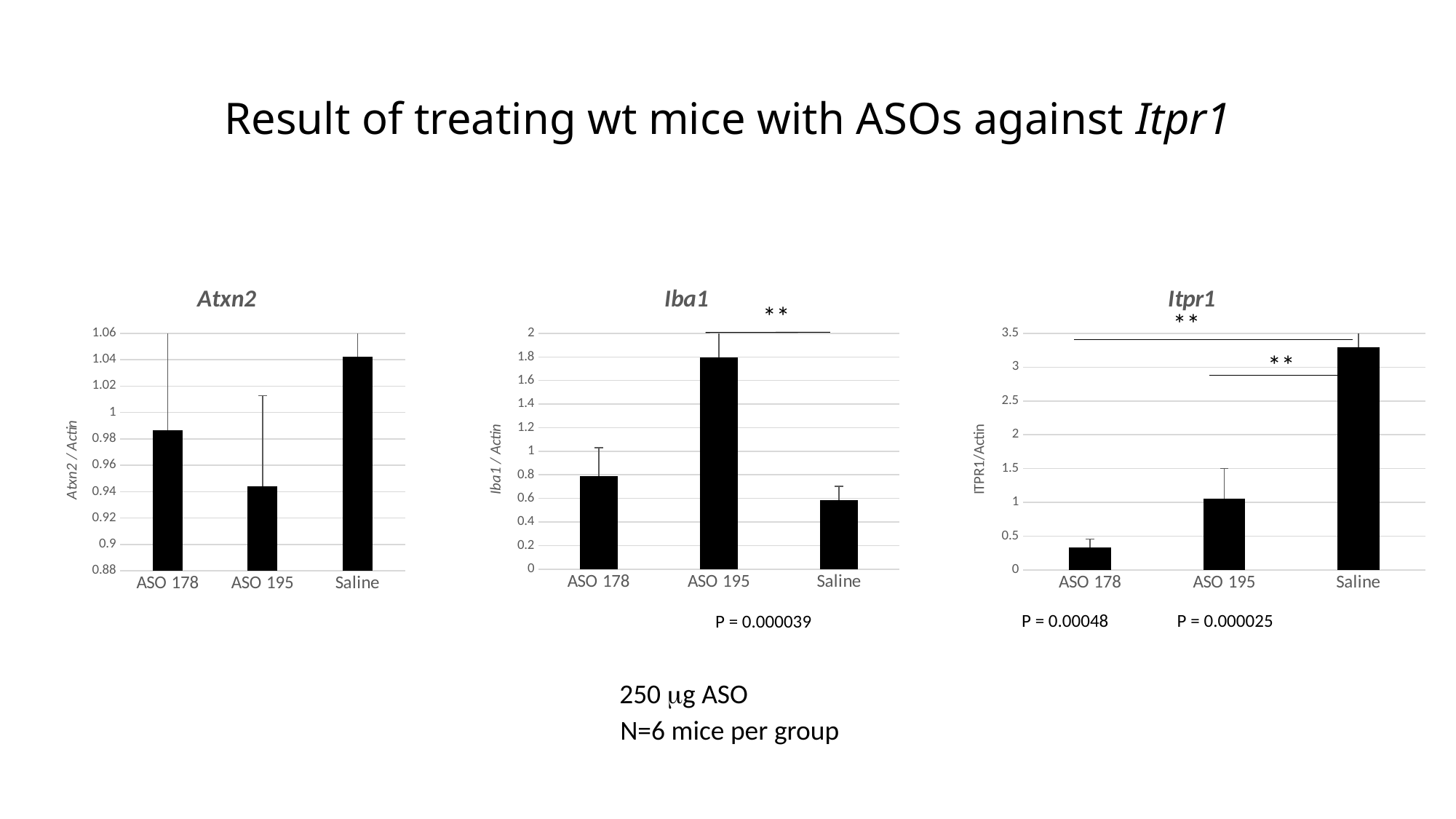
In the Iba1 chart, which is larger, the value for ASO 178 or the value for Saline? ASO 178 In the Itpr1 chart, is the value for ASO 178 greater or less than 0.5? less In the Atxn2 chart, is the value for Saline greater or less than 1.02? greater In the Atxn2 chart, which category has the highest value? Saline In the Atxn2 chart, which category has the lowest value? ASO 195 In the Itpr1 chart, is the value for Saline greater or less than 3? greater In the Iba1 chart, which category has the highest value? ASO 195 How many categories are shown in the Itpr1 chart? 3 What kind of chart is the Iba1 chart? bar chart In the Itpr1 chart, which category has the lowest value? ASO 178 In the Iba1 chart, which category has the lowest value? Saline